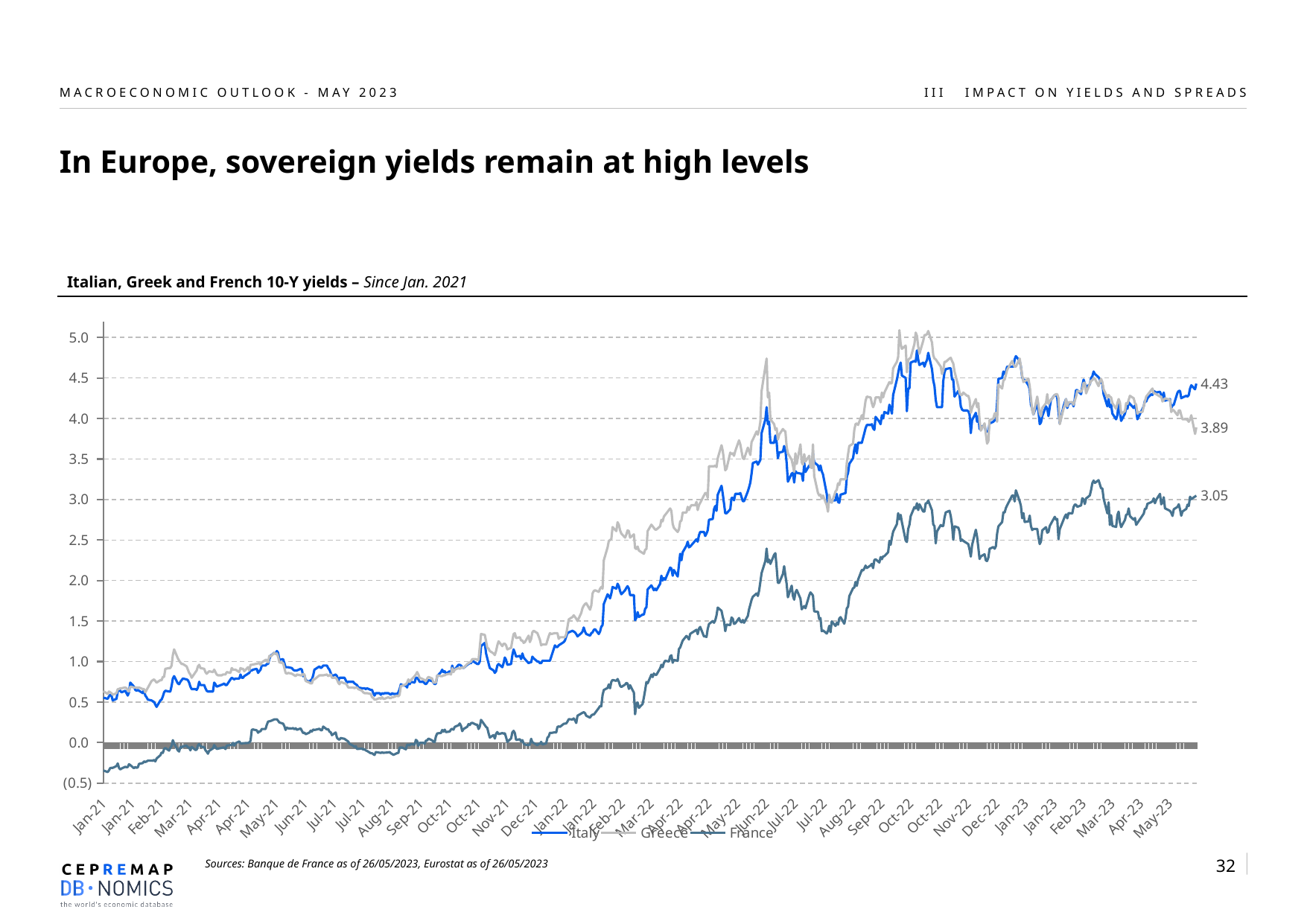
How many series does the legend list? 3 What is the latest value labelled for France's 10-Y yield? 3.05 What is the latest value labelled for Greece's 10-Y yield? 3.89 Which country has the highest 10-Y yield at the end of the series? Italy Which country has the lowest 10-Y yield at the end of the series? France Which series are listed in the legend? Italy, Greece, France What type of chart is shown on the slide? line chart Is the Italian 10-Y yield in Jan-21 greater or less than 1.0? less What is the latest value labelled for Italy's 10-Y yield? 4.43 Does the French 10-Y yield rise or fall overall from Jan-21 to May-23? rise What is the difference between the latest labelled Italian and French yields? 1.38 Is the French 10-Y yield at the start of the series (Jan-21) greater or less than 0.0? less